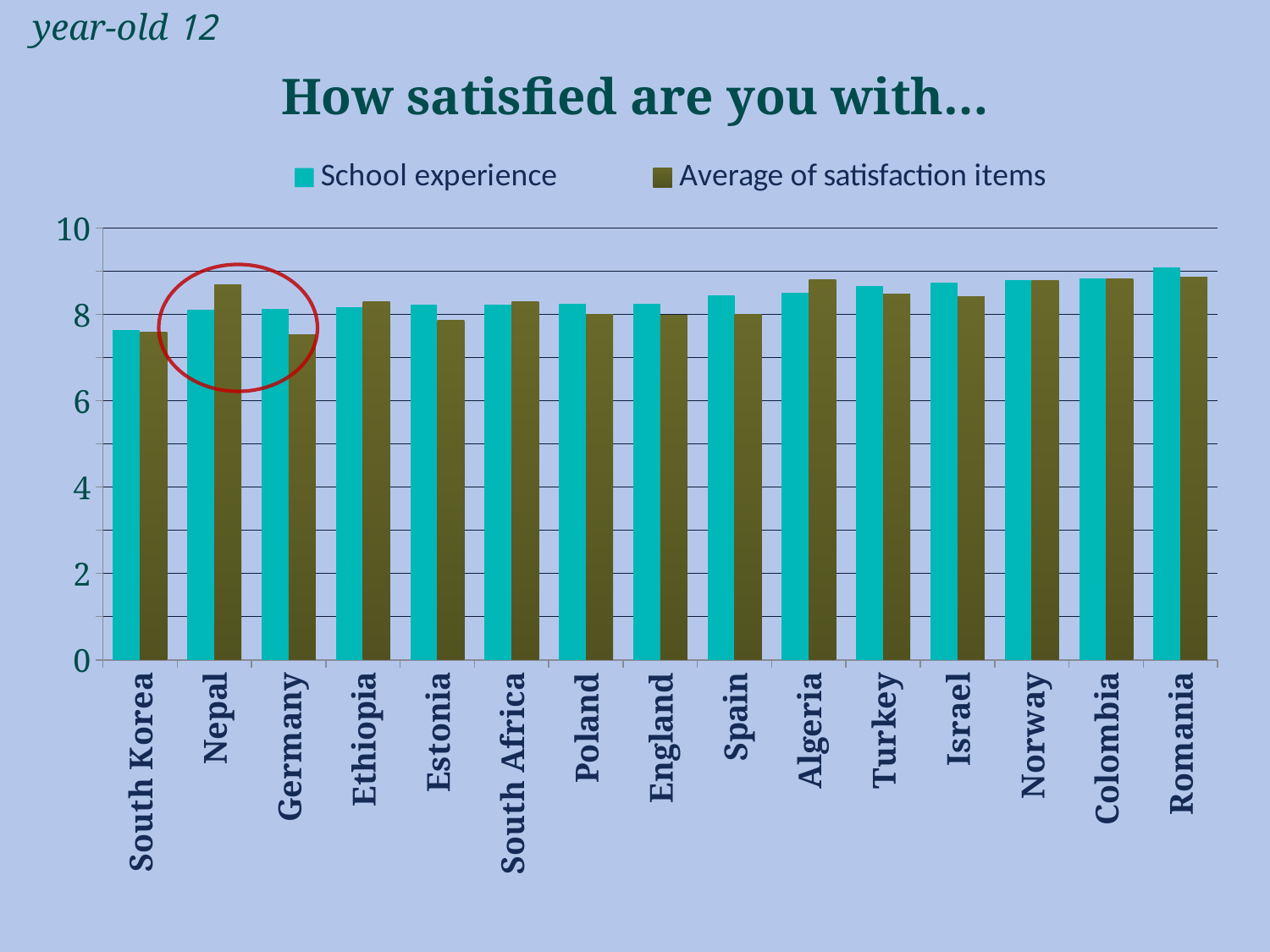
Which country's bars are circled in red on the chart? Nepal and Germany For Nepal, which is larger: School experience or Average of satisfaction items? Average of satisfaction items What kind of chart is shown on the slide? Bar chart For Germany, which is larger: School experience or Average of satisfaction items? School experience Is the Average of satisfaction items value for Germany greater or less than 8? less Is the Average of satisfaction items value for Nepal greater or less than 8? greater Which country has the highest value for School experience? Romania Which country has the lowest value for School experience? South Korea Is the School experience value for South Korea greater or less than 8? less How many countries are shown on the x axis of the chart? 15 Do the School experience values generally rise or fall from left to right across the countries? Rise How many series does the legend list? 2